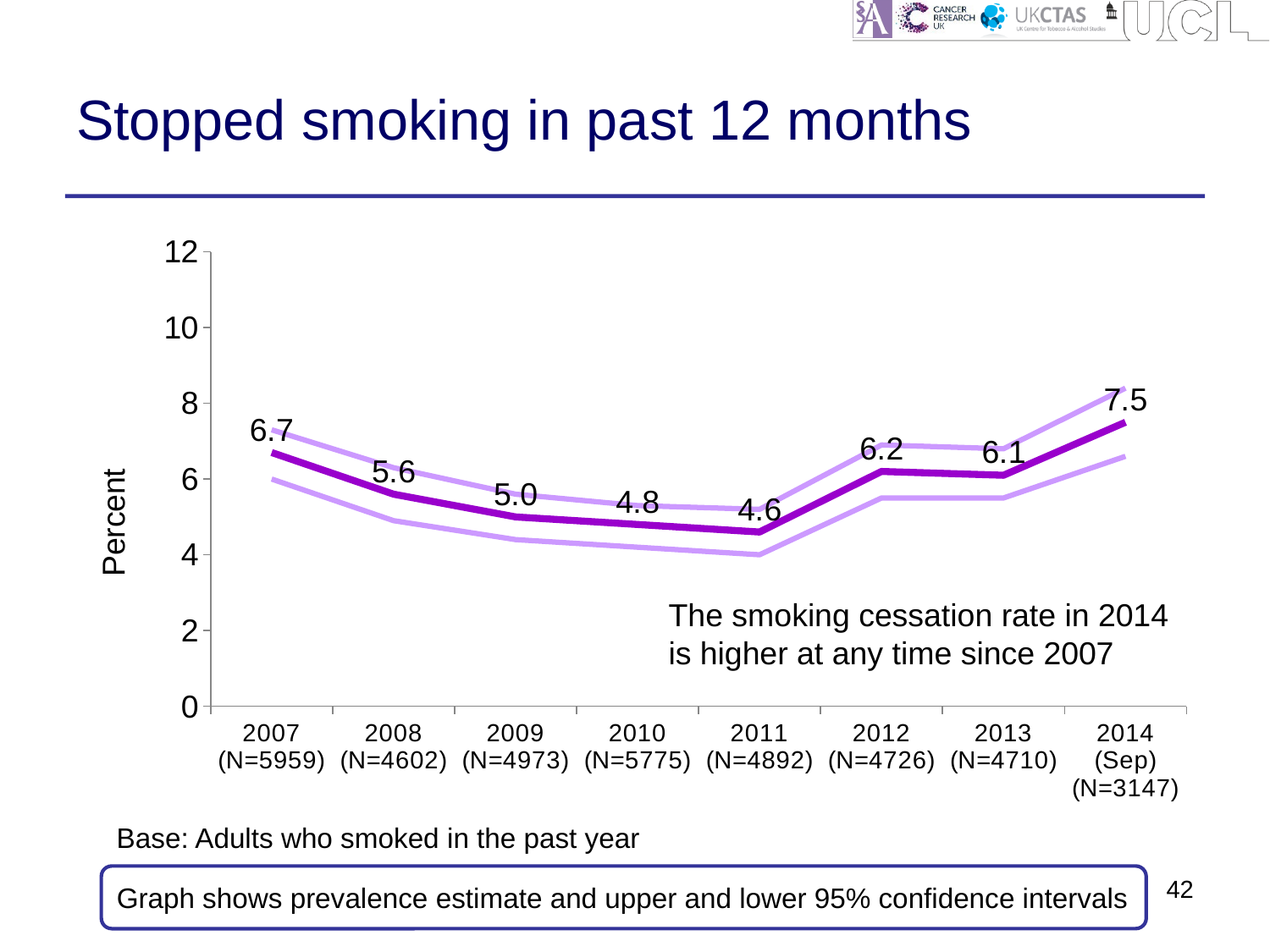
What is the value shown for 2008? 5.6 How many years are plotted on the x axis? 8 What is the percentage of adults who stopped smoking in the past 12 months in 2011? 4.6 What is the label on the y axis? Percent Which year has the lowest smoking cessation rate? 2011 Is the value for 2009 greater or less than 6? less What kind of chart is shown on the slide? line chart What is the value shown for 2014 (Sep)? 7.5 What is the difference between the 2014 (Sep) value and the 2007 value? 0.8 Which is larger, the value for 2012 or the value for 2013? 2012 Which year has the highest smoking cessation rate? 2014 (Sep) Does the smoking cessation rate rise or fall from 2007 to 2011? fall